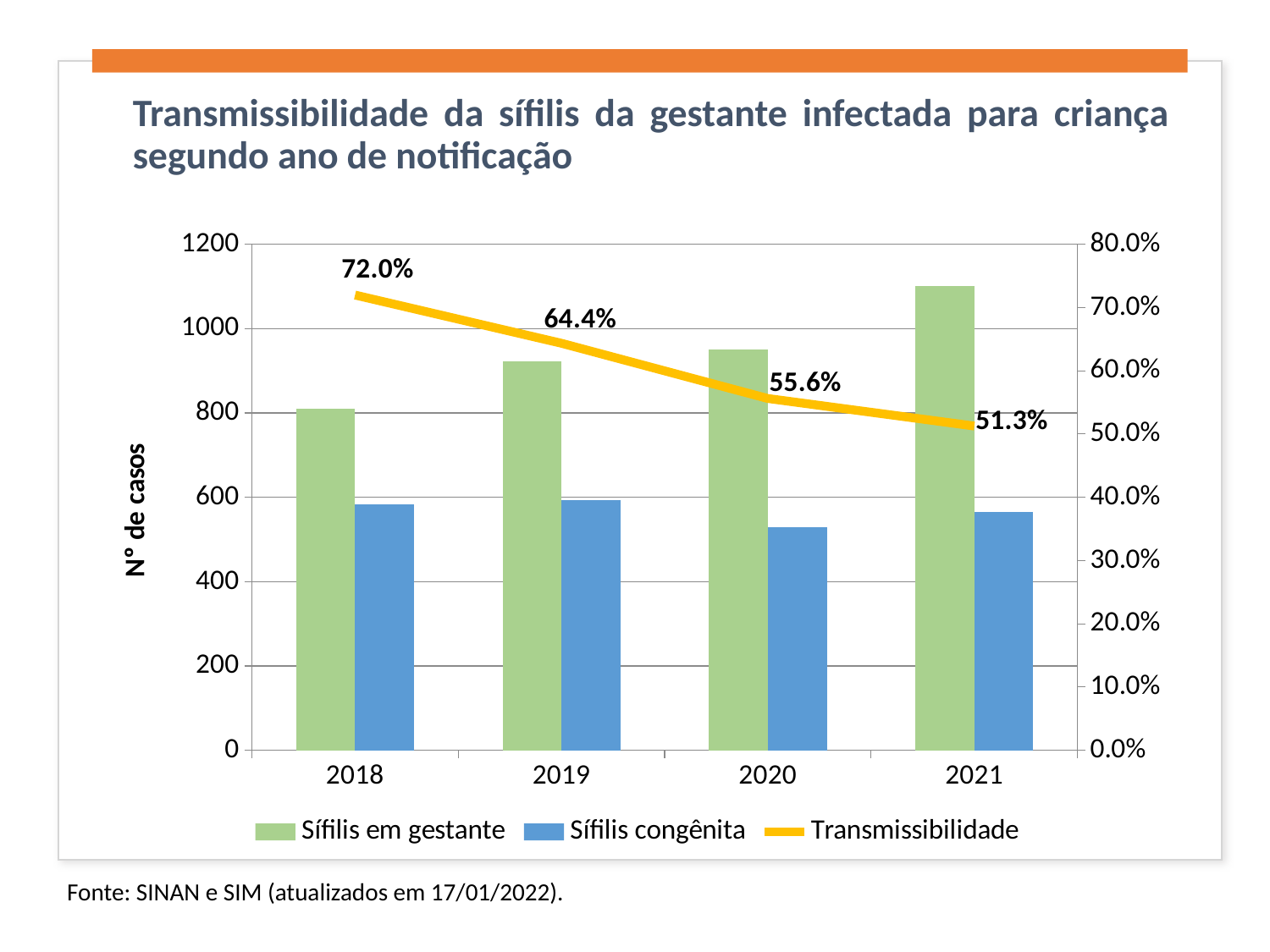
How many series does the legend list? 3 What is the Transmissibilidade value for 2020? 55.6% In which year is the Sífilis congênita bar lowest? 2020 What is the Transmissibilidade value for 2021? 51.3% Does the Transmissibilidade line rise or fall from 2018 to 2021? It falls In which year is the Sífilis em gestante bar highest? 2021 Is the Sífilis congênita value for 2020 greater or less than 600? less In which year is the Sífilis em gestante bar lowest? 2018 What is the Transmissibilidade value for 2018? 72.0% How many years are shown on the x axis? 4 Is the Sífilis em gestante value for 2021 greater or less than 1000? greater By how many percentage points did Transmissibilidade fall from 2018 to 2021? 20.7 percentage points